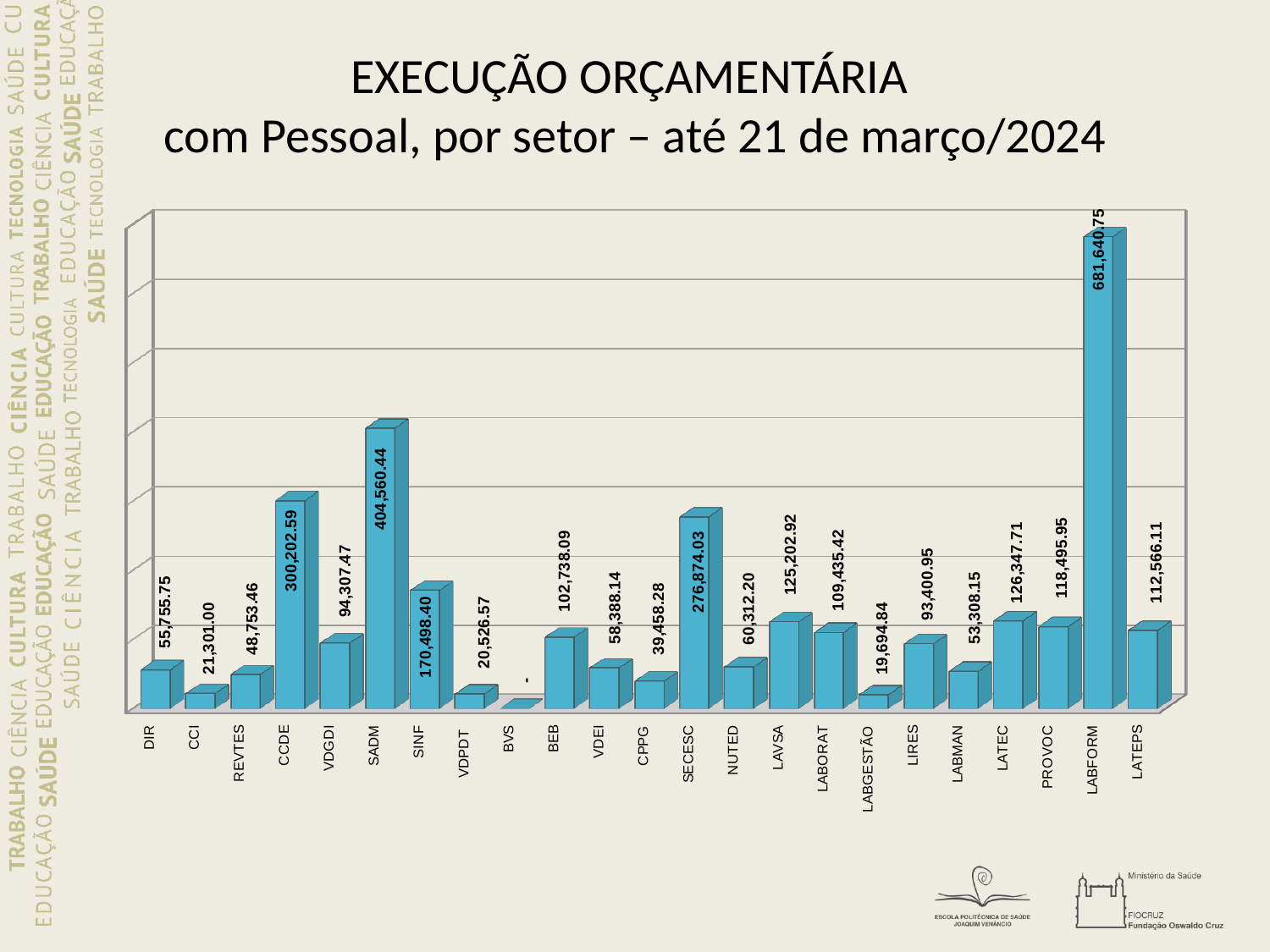
What is the value for LABGESTÃO? 19,694.84 Which is larger, the value for SINF or the value for BEB? SINF What is the value for LATEPS? 112,566.11 What is the value for LABFORM? 681,640.75 What is the difference between the values for CCDE and SECESC? 23,328.56 Which sector has the highest value? LABFORM What is the value for SADM? 404,560.44 How many sectors are shown on the x axis? 23 What kind of chart is shown on the slide? Bar chart Excluding BVS, which has no value shown, which sector has the lowest value? LABGESTÃO What is the value for SECESC? 276,874.03 What is the difference between the values for LABFORM and SADM? 277,080.31